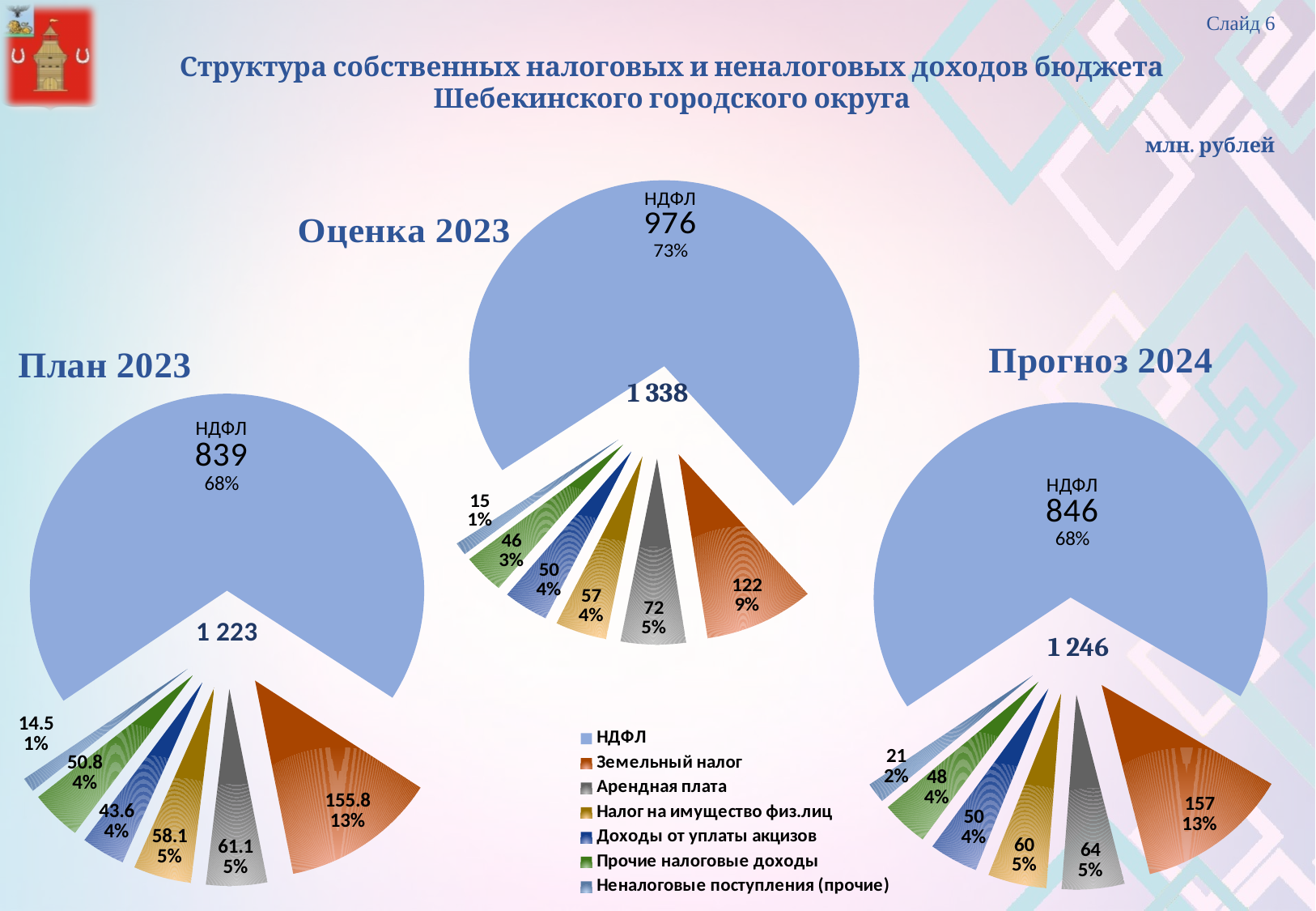
In the Прогноз 2024 pie chart, which category has the largest value? НДФЛ In the Прогноз 2024 pie chart, what is the value for Земельный налог (the orange slice)? 157 In the Оценка 2023 pie chart, what share of the total does НДФЛ represent? 73% Which is larger: the Арендная плата value in Оценка 2023 (72) or in Прогноз 2024 (64)? Оценка 2023 In the Прогноз 2024 pie chart, what share does Неналоговые поступления (прочие) represent? 2% How many entries does the legend list? 7 How many pie charts are shown on the slide? 3 In the План 2023 pie chart, which category has the smallest value? Неналоговые поступления (прочие) In the План 2023 pie chart, what is the value for НДФЛ? 839 What is the total shown in the centre of the Оценка 2023 pie chart? 1 338 What type of chart is used on this slide? Pie chart What is the difference between the НДФЛ value in Оценка 2023 and the НДФЛ value in План 2023? 137